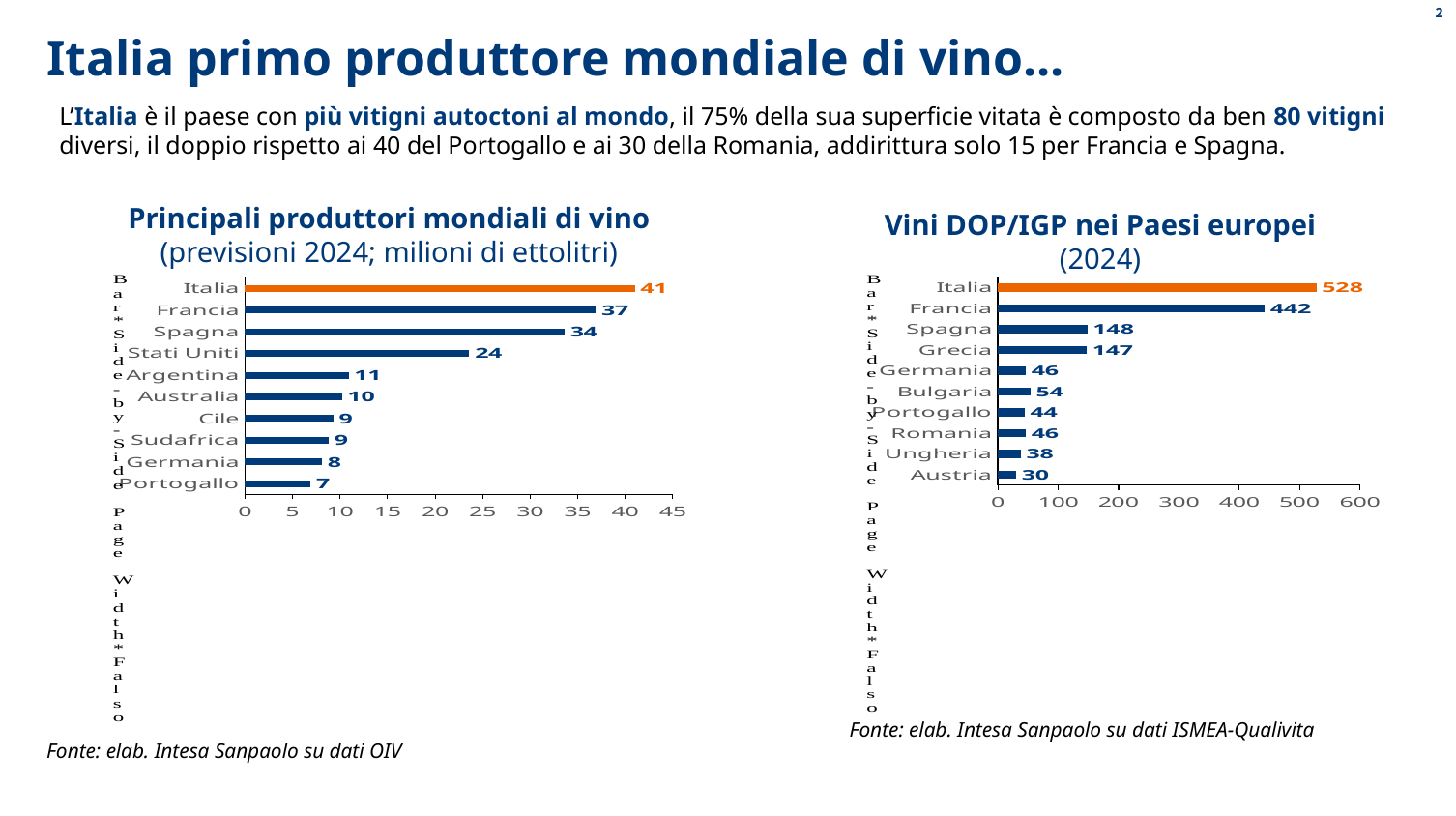
In the chart 'Vini DOP/IGP nei Paesi europei', which has a larger value, Bulgaria or Portogallo? Bulgaria In the chart 'Vini DOP/IGP nei Paesi europei', what is the difference between the values for Italia and Francia? 86 In the chart 'Principali produttori mondiali di vino', what is the difference between the values for Italia and Francia? 4 In the chart 'Principali produttori mondiali di vino', which country has the lowest value? Portogallo In the chart 'Vini DOP/IGP nei Paesi europei', what is the value for Grecia? 147 In the chart 'Vini DOP/IGP nei Paesi europei', which country has the highest value? Italia In the chart 'Principali produttori mondiali di vino', what is the value for Stati Uniti? 24 In the chart 'Vini DOP/IGP nei Paesi europei', which country has the lowest value? Austria In the chart 'Principali produttori mondiali di vino', what is the value for Spagna? 34 What type of chart is 'Principali produttori mondiali di vino'? Bar chart In the chart 'Vini DOP/IGP nei Paesi europei', what is the value for Ungheria? 38 In the chart 'Principali produttori mondiali di vino', how many countries are shown? 10